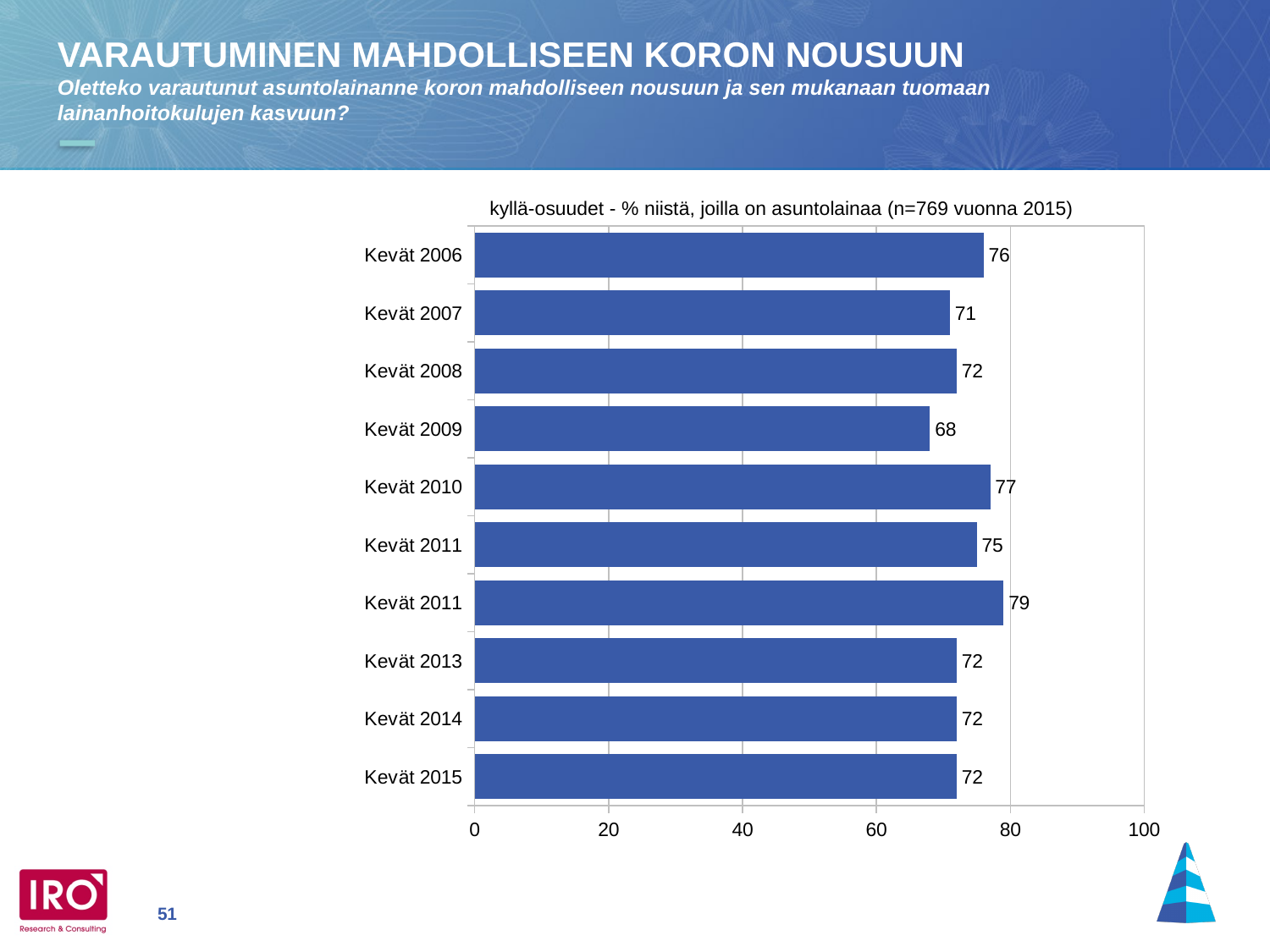
What is the value for Kevät 2006? 76 What is the highest value shown in the chart? 79 What is the title of the chart? kyllä-osuudet - % niistä, joilla on asuntolainaa (n=769 vuonna 2015) What is the value for Kevät 2010? 77 How many bars are shown in the chart? 10 What is the difference between the values for Kevät 2010 and Kevät 2009? 9 Which is larger, the value for Kevät 2006 or the value for Kevät 2007? Kevät 2006 What kind of chart is shown on the slide? bar chart What is the value for Kevät 2009? 68 Is the value for Kevät 2009 greater or less than 80? less Which category has the lowest value? Kevät 2009 What is the value for Kevät 2015? 72